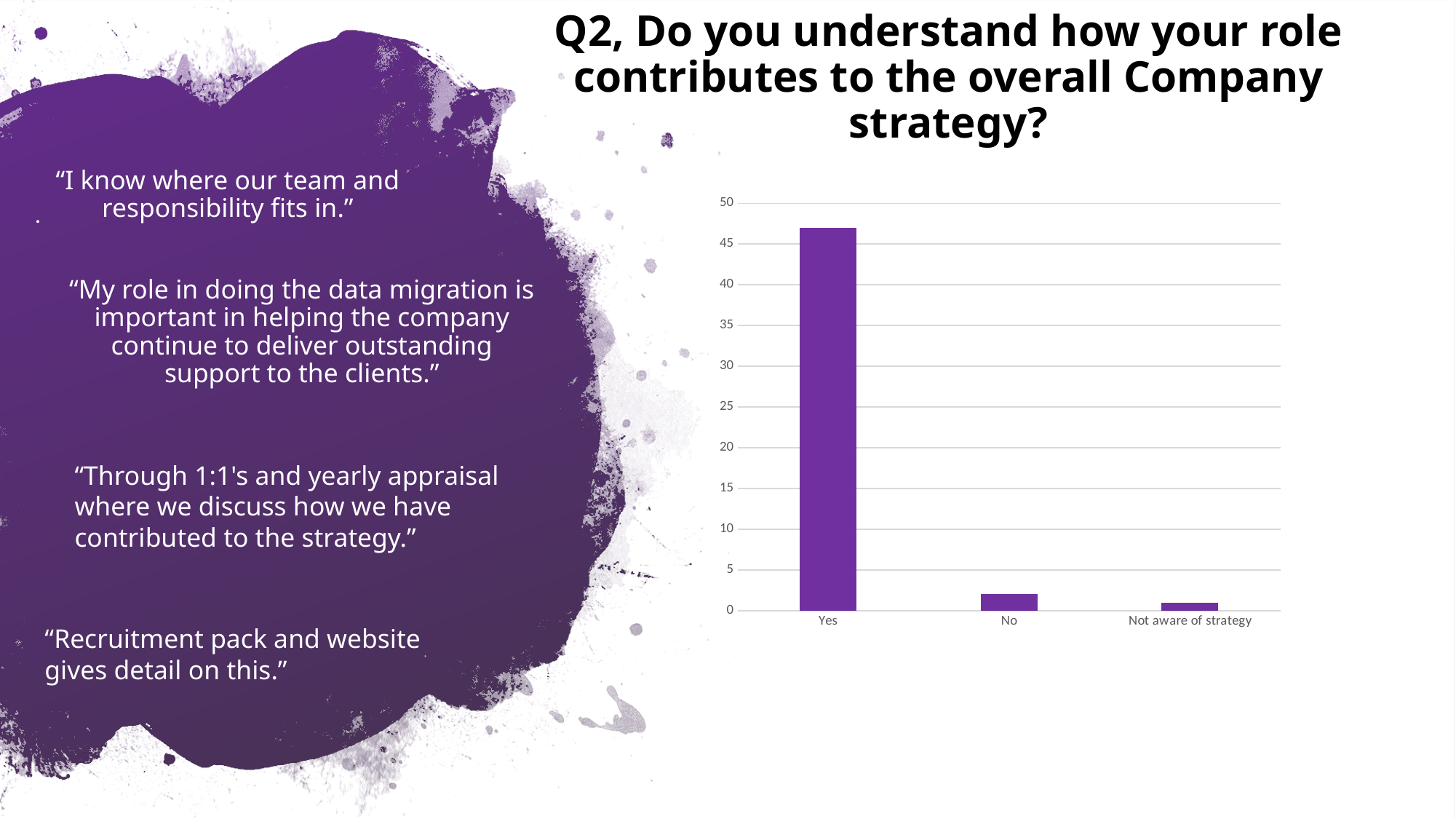
What colour are the bars in the chart? purple Which category has the lowest value in the chart? Not aware of strategy Is the value for No greater or less than 5? less Is the value for Not aware of strategy greater or less than 5? less How many categories are shown on the x axis of the chart? 3 Is the value for Yes greater or less than 40? greater What is the highest value shown on the chart's vertical axis? 50 Which is larger, the value for No or the value for Not aware of strategy? No Which is larger, the value for Yes or the value for No? Yes What kind of chart is shown on the slide? bar chart Which category has the highest value in the chart? Yes